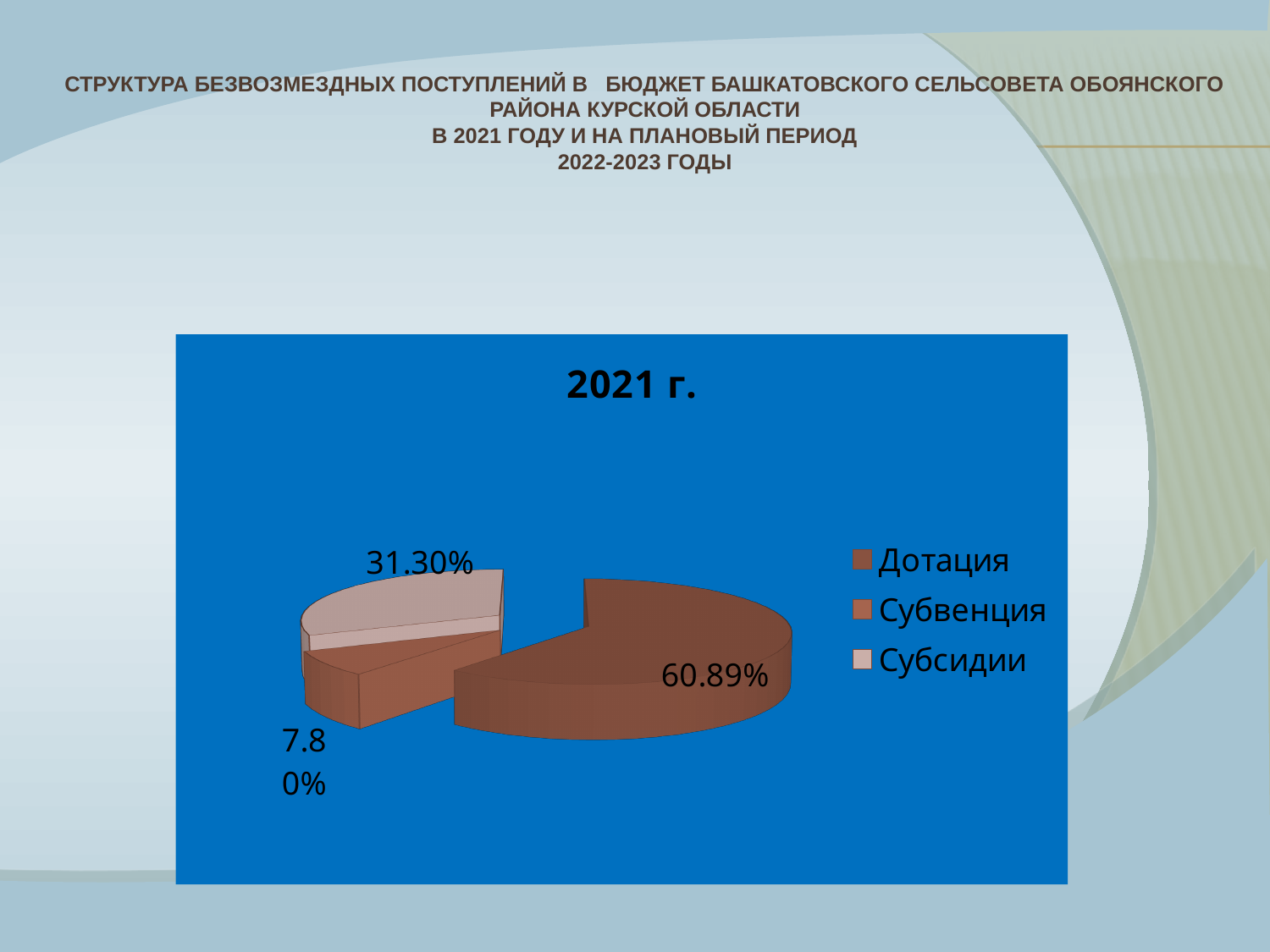
How many slices does the pie chart have? 3 Which category has the smallest slice of the pie? Субвенция What kind of chart is shown on the slide? pie chart What share of the pie does Дотация have? 60.89% What share of the pie does Субсидии have? 31.30% Which legend entry is listed first? Дотация What is the difference between the share for Дотация and the share for Субсидии? 29.59% Which category has the largest slice of the pie? Дотация How many entries does the legend list? 3 What is the title of the chart? 2021 г. What share of the pie does Субвенция have? 7.80% Which is larger, the share for Субсидии or the share for Субвенция? Субсидии